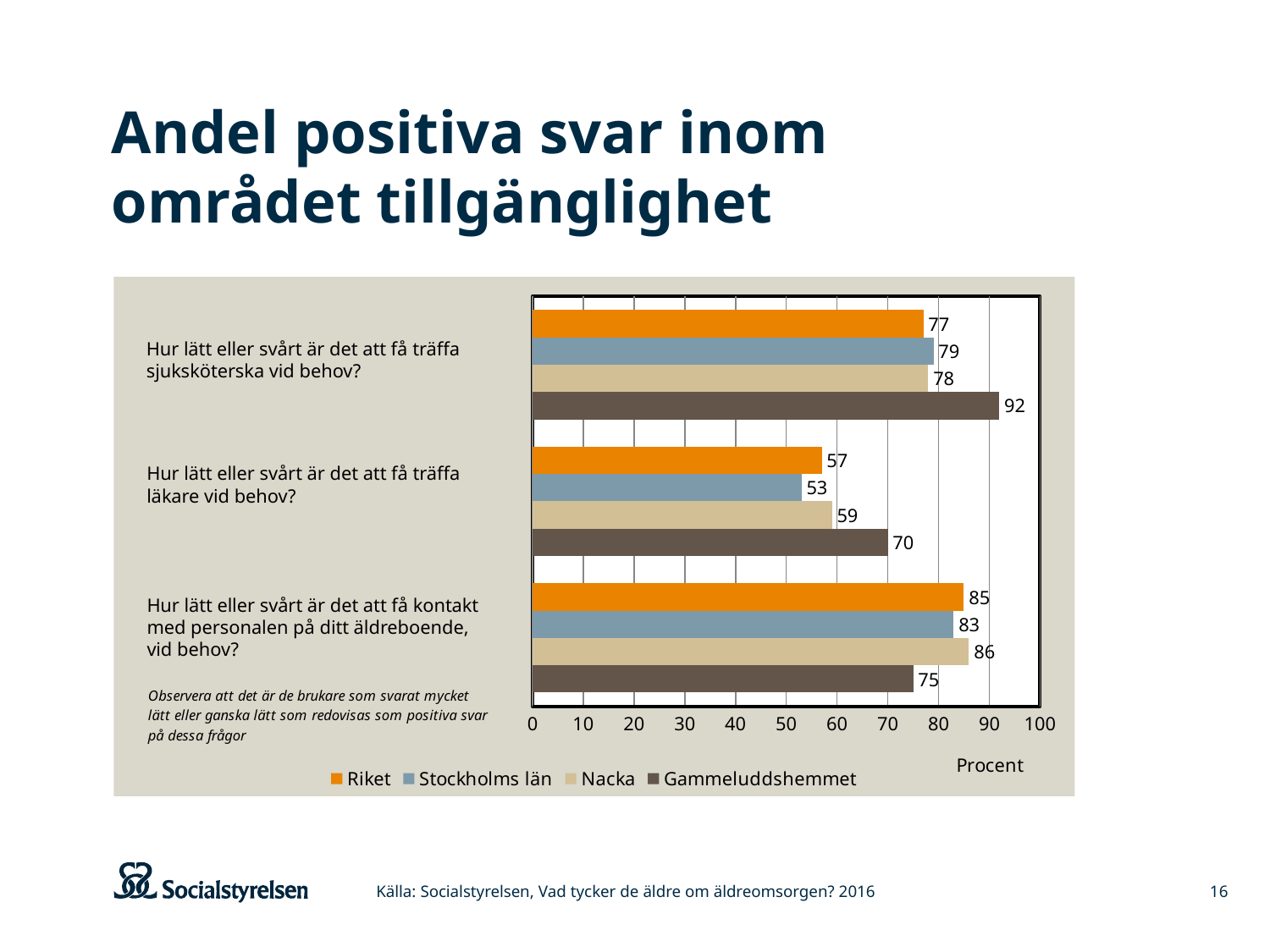
Which is larger for the question about getting in contact with staff: Riket or Stockholms län? Riket What is the value for Stockholms län for the question about meeting a doctor (läkare) when needed? 53 What is the value for Nacka for the question about getting in contact with staff at the care home? 86 What is the value for Riket for the question about meeting a nurse when needed? 77 What is the difference between Gammeluddshemmet and Riket for the question about meeting a doctor when needed? 13 Which series has the lowest value for the question about getting in contact with staff at the care home? Gammeluddshemmet Which series has the highest value for the question about meeting a nurse when needed? Gammeluddshemmet What is the value for Gammeluddshemmet for the question about meeting a nurse (sjuksköterska) when needed? 92 How many series does the legend list? 4 What kind of chart is shown on the slide? Bar chart What is the label of the horizontal axis? Procent How many question categories are shown on the chart? 3